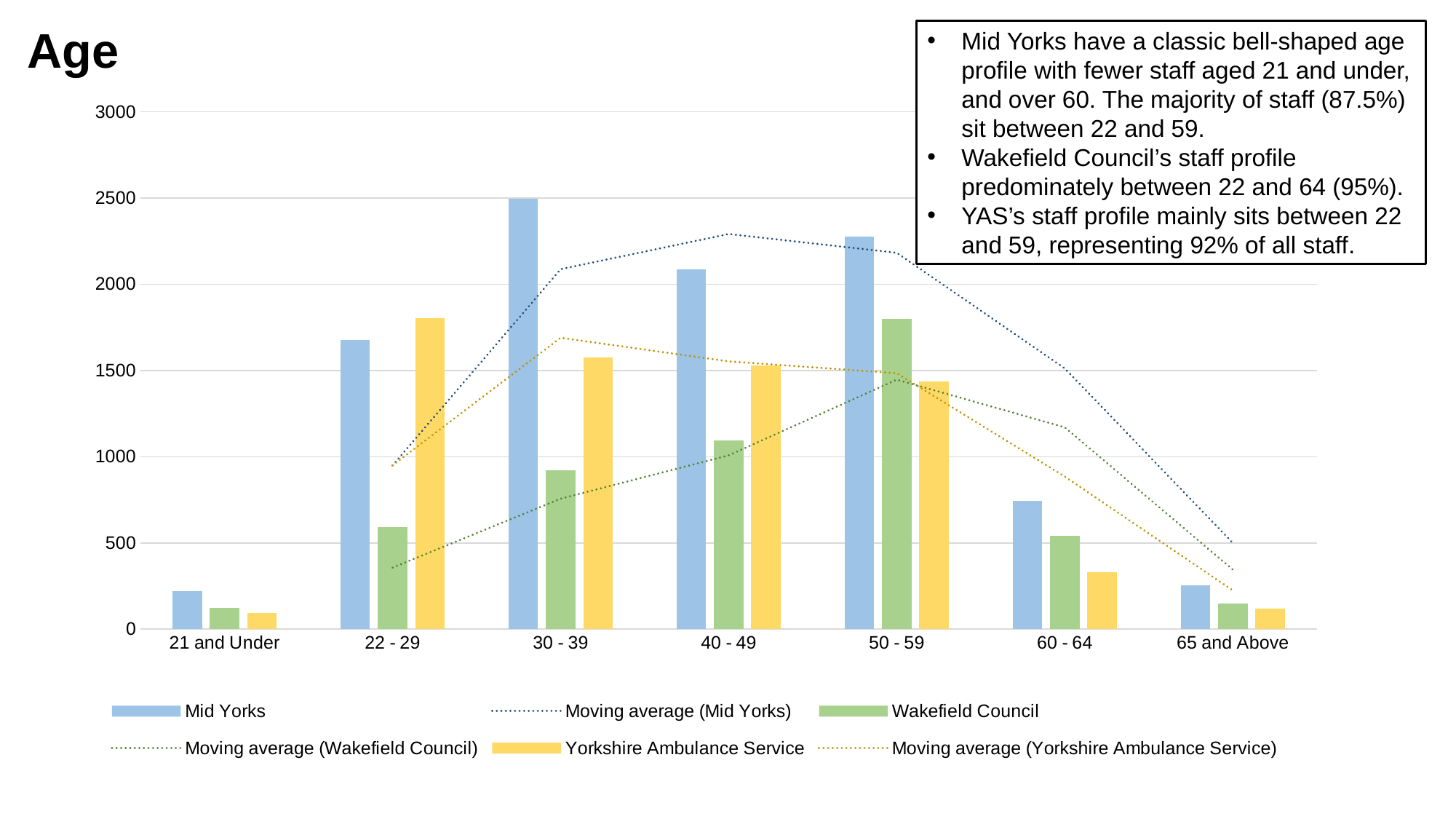
Is the Yorkshire Ambulance Service value for 60 - 64 greater or less than 500? less Which age category has the highest Yorkshire Ambulance Service bar? 22 - 29 How many age categories are shown on the x axis? 7 In the 50 - 59 category, which is larger: Wakefield Council or Yorkshire Ambulance Service? Wakefield Council How many series does the legend list? 6 Is the Mid Yorks value for 30 - 39 greater or less than 2000? greater Which age category has the highest Mid Yorks bar? 30 - 39 Does the Moving average (Mid Yorks) line rise or fall from 50 - 59 to 65 and Above? fall In the 40 - 49 category, which is larger: Mid Yorks or Wakefield Council? Mid Yorks Which age category has the highest Wakefield Council bar? 50 - 59 Is the Wakefield Council value for 50 - 59 greater or less than 1500? greater What kind of chart is shown on the slide? bar chart